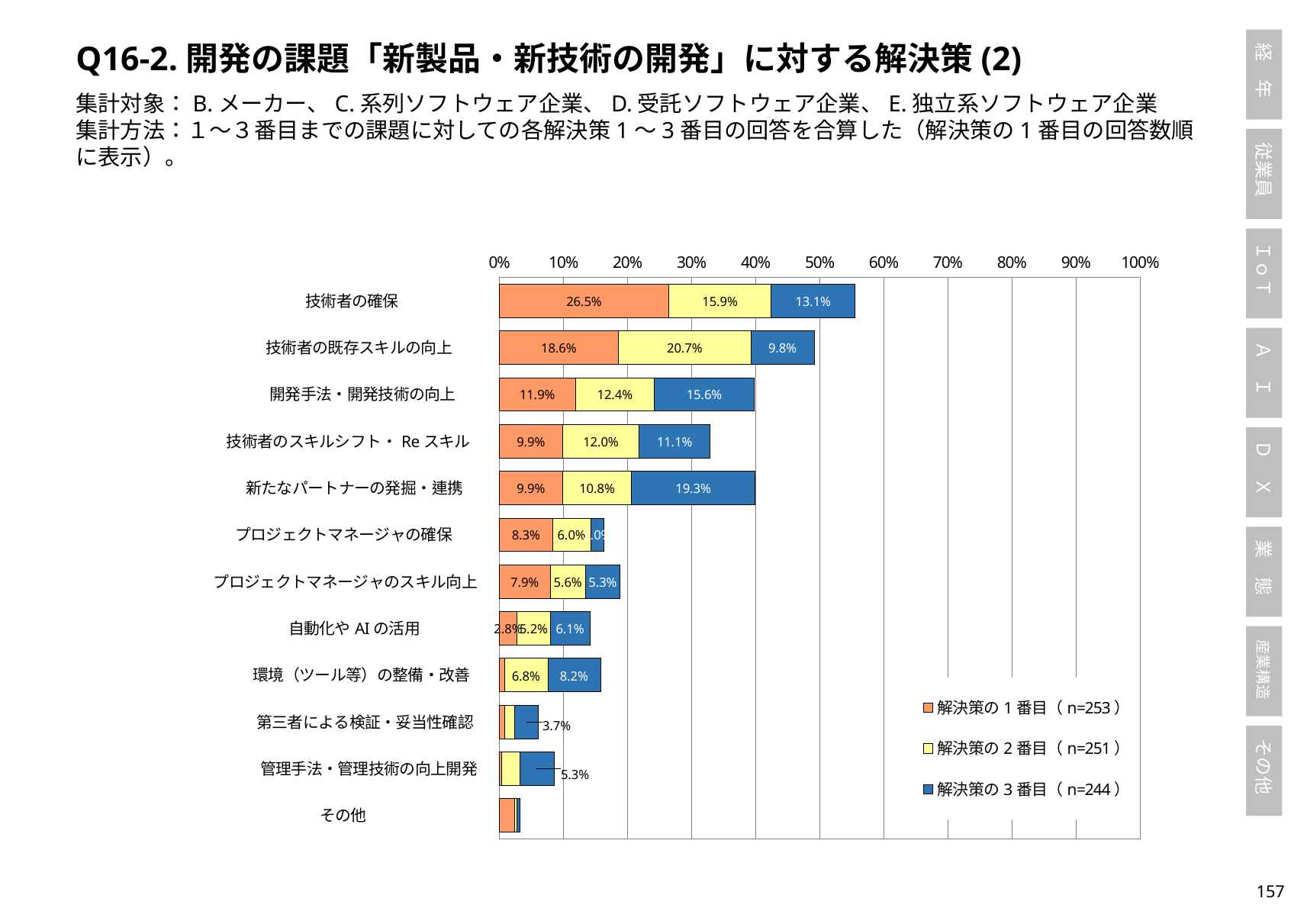
How many categories are plotted on the vertical axis? 12 Which category has the highest value for 解決策の3番目? 新たなパートナーの発掘・連携 What is the value of 解決策の3番目 for 新たなパートナーの発掘・連携? 19.3% What is the value of 解決策の3番目 for 自動化やAIの活用? 6.1% What is the total of the stacked bar for 技術者の確保? 55.5% What is the value of 解決策の1番目 for 技術者の確保? 26.5% What is the n value shown in the legend for 解決策の2番目? n=251 Which category has the highest value for 解決策の1番目? 技術者の確保 How many series does the legend list? 3 For 技術者の既存スキルの向上, how much larger is 解決策の2番目 than 解決策の1番目? 2.1 percentage points What kind of chart is shown on the slide? bar chart Which is larger: 解決策の3番目 for 開発手法・開発技術の向上 or 解決策の3番目 for 技術者の確保? 開発手法・開発技術の向上